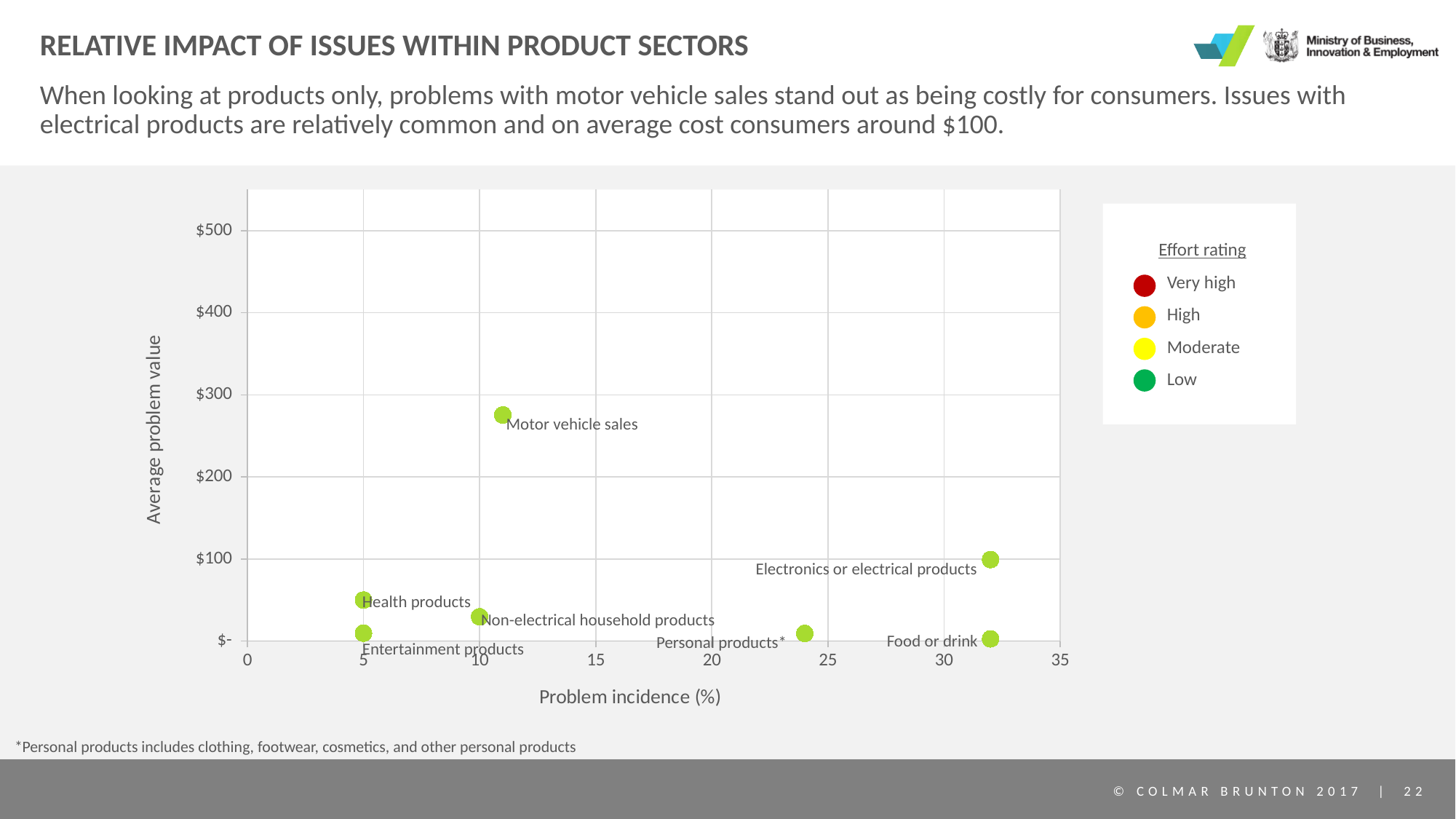
Is the average problem value for Health products greater or less than $100? less Is the problem incidence for Personal products greater or less than 20%? greater How many product sectors are plotted on the chart? 7 Is the average problem value for Motor vehicle sales greater or less than $200? greater Which has a higher problem incidence, Personal products or Motor vehicle sales? Personal products Which has a higher average problem value, Motor vehicle sales or Electronics or electrical products? Motor vehicle sales What kind of chart is shown on the slide? Scatter chart Which product sector has the highest average problem value? Motor vehicle sales How many effort rating levels does the legend list? 4 What is the label on the x axis of the chart? Problem incidence (%)